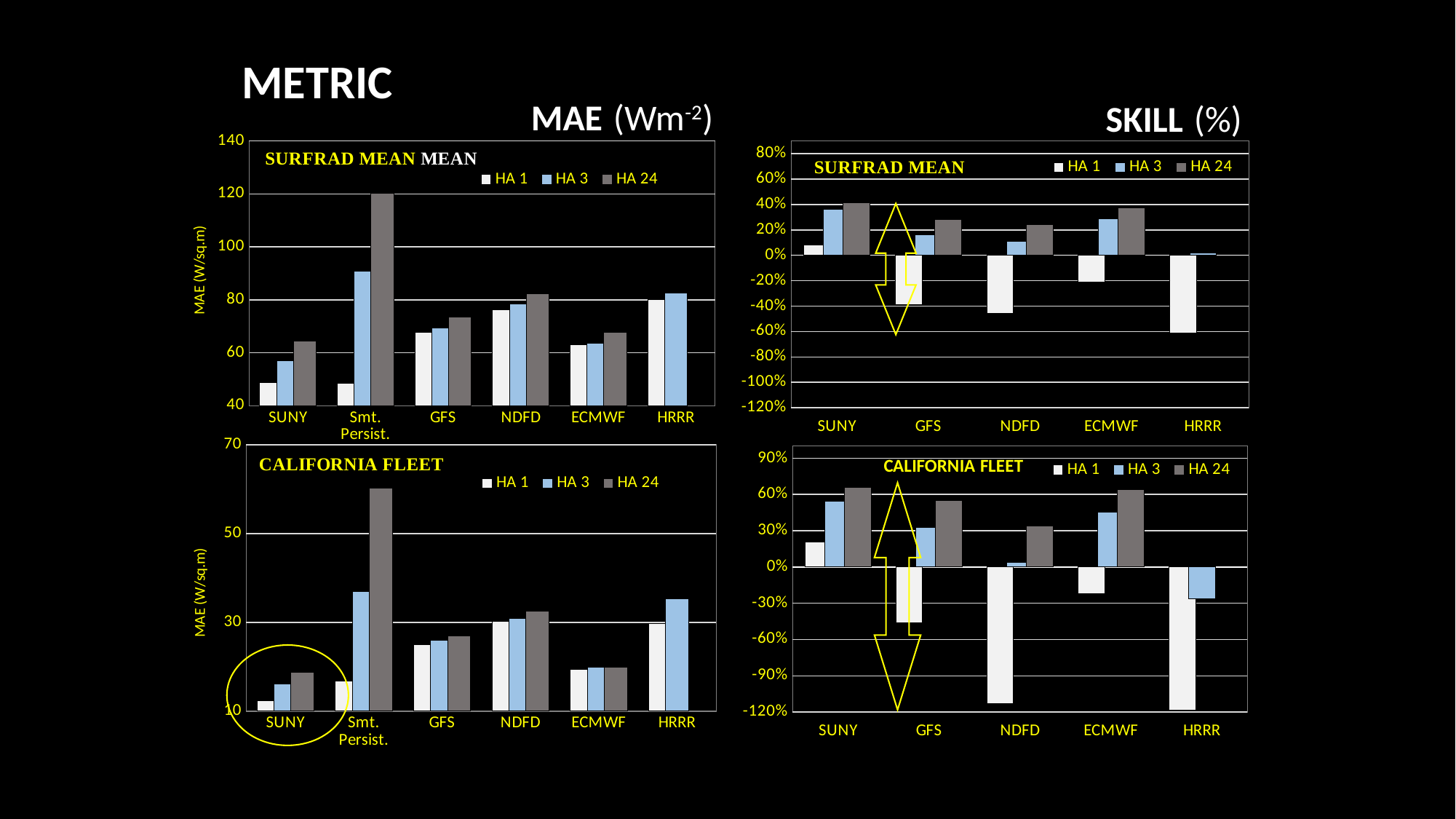
In the MAE SURFRAD MEAN chart (top left), is the HA 24 value for Smt. Persist. greater or less than 100? greater In the MAE CALIFORNIA FLEET chart (bottom left), which category has the lowest HA 1 value? SUNY In the MAE SURFRAD MEAN chart (top left), which is larger: the HA 3 value for Smt. Persist. or the HA 3 value for HRRR? Smt. Persist. How many series does the legend list in the SKILL CALIFORNIA FLEET chart (bottom right)? 3 In the MAE SURFRAD MEAN chart (top left), is the HA 24 value for SUNY greater or less than 80? less In the MAE CALIFORNIA FLEET chart (bottom left), is the HA 3 value for HRRR greater or less than 30? greater What kind of chart is the SKILL SURFRAD MEAN chart (top right)? bar chart In the MAE SURFRAD MEAN chart (top left), which category has the tallest bar? Smt. Persist. In the SKILL SURFRAD MEAN chart (top right), which category has the lowest HA 1 value? HRRR How many categories are shown on the x axis of the MAE CALIFORNIA FLEET chart (bottom left)? 6